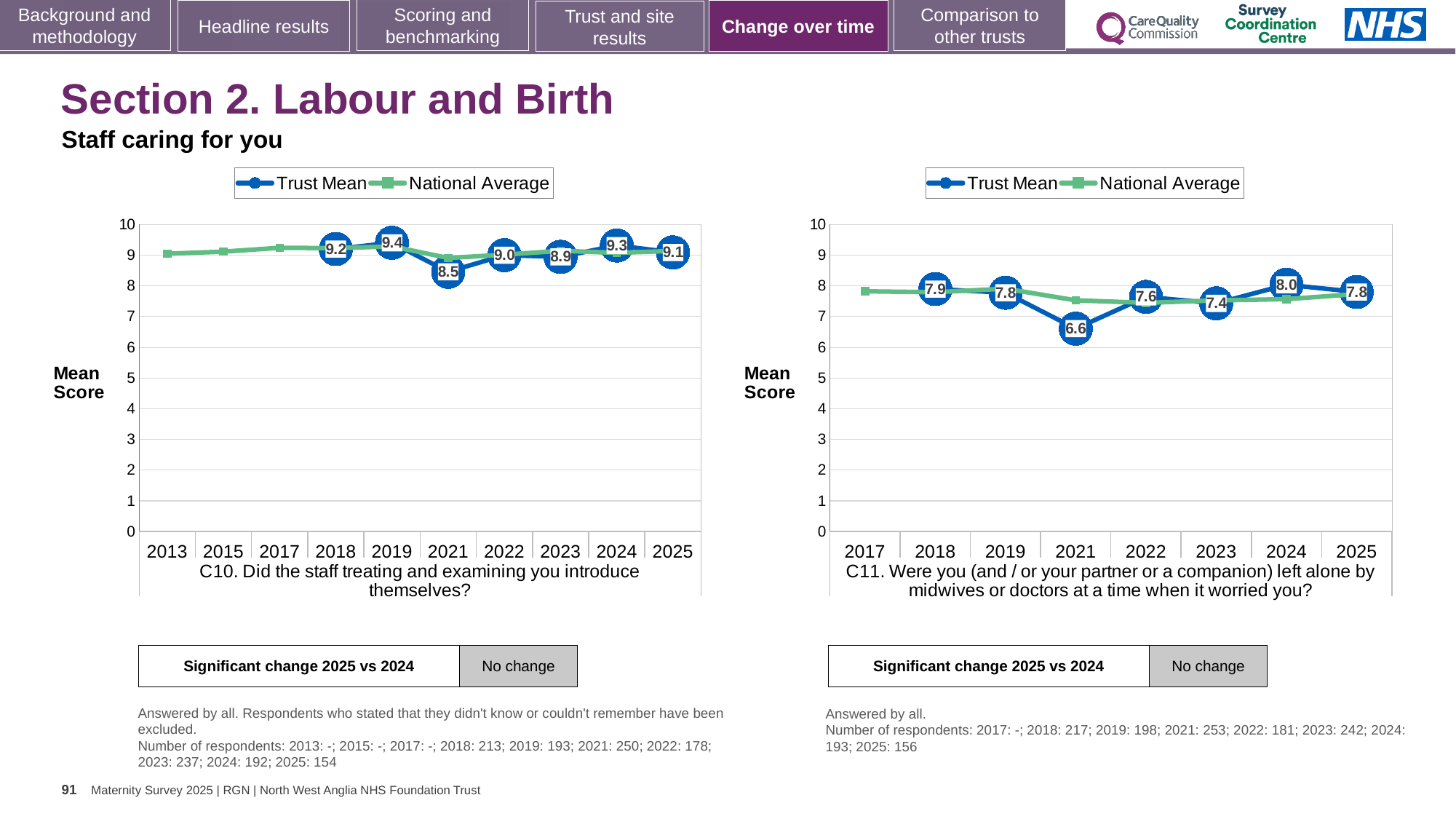
In the C10 chart (left), which year has the lowest Trust Mean score? 2021 How many years are shown on the x axis of the C11 chart (right)? 8 In the C10 chart (left), what is the Trust Mean score for 2019? 9.4 How many series does the legend of the C10 chart (left) list? 2 What type of chart is the C10 chart (left)? Line chart In the C11 chart (right), what is the Trust Mean score for 2025? 7.8 In the C11 chart (right), what is the Trust Mean score for 2021? 6.6 In the C11 chart (right), what is the difference between the Trust Mean scores for 2024 and 2021? 1.4 In the C10 chart (left), is the Trust Mean score higher in 2024 or in 2023? 2024 In the C11 chart (right), is the National Average value for 2021 greater or less than 7? greater In the C10 chart (left), what is the Trust Mean score for 2021? 8.5 In the C11 chart (right), which year has the highest Trust Mean score? 2024